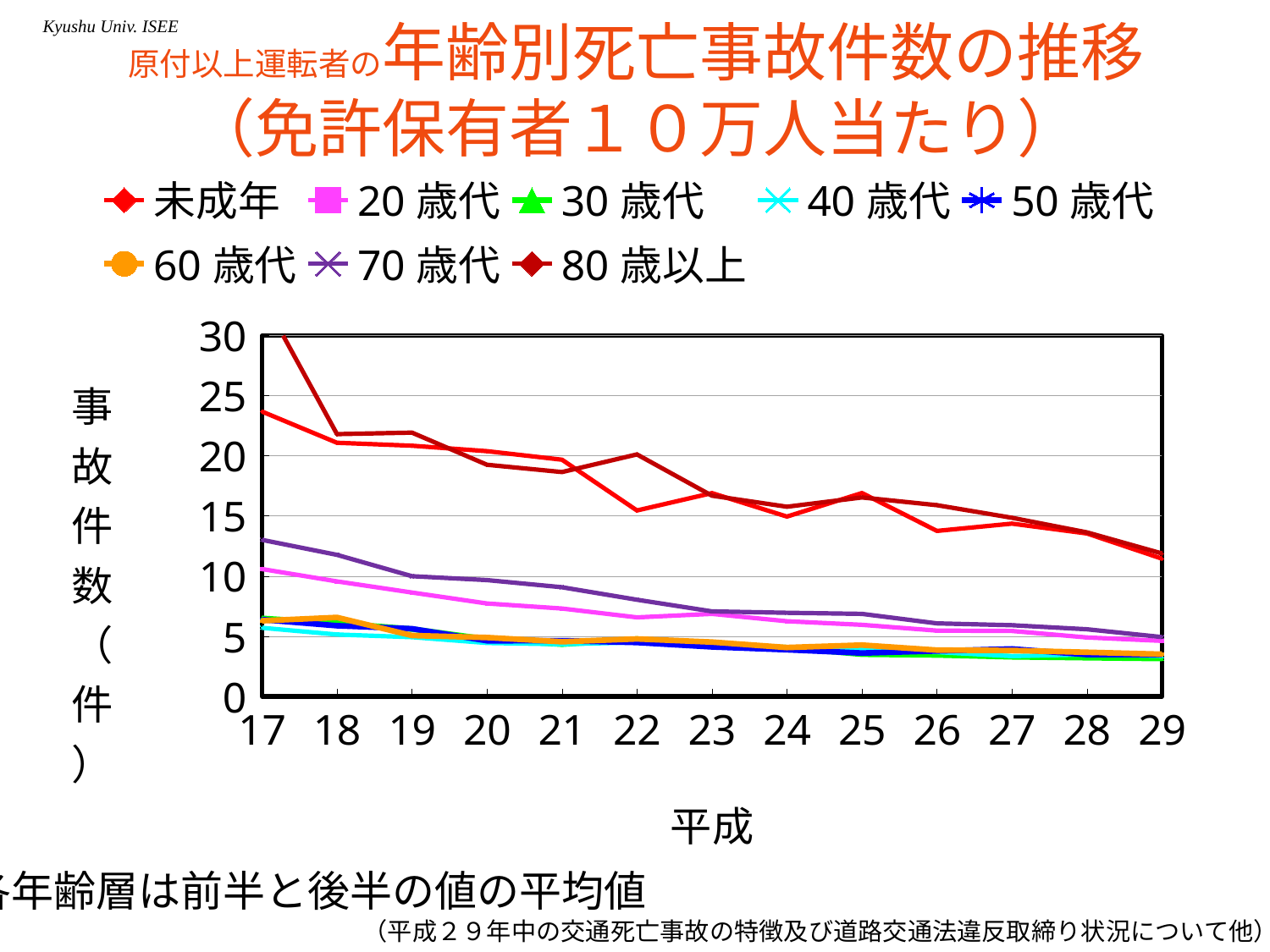
How many years (points) are shown along the x axis? 13 Is the value for 70 歳代 at 平成17 greater or less than 10? greater What is the label of the x axis? 平成 At 平成17, which is larger: the value for 70 歳代 or the value for 20 歳代? 70 歳代 What kind of chart is shown on the slide? line chart Does the value for 未成年 generally rise or fall from 平成17 to 平成29? fall How many series does the legend list? 8 Which series has the highest value at 平成17? 80 歳以上 Is the value for 70 歳代 at 平成22 greater or less than 10? less Is the value for 未成年 at 平成26 greater or less than 15? less Which series has the highest value at 平成22? 80 歳以上